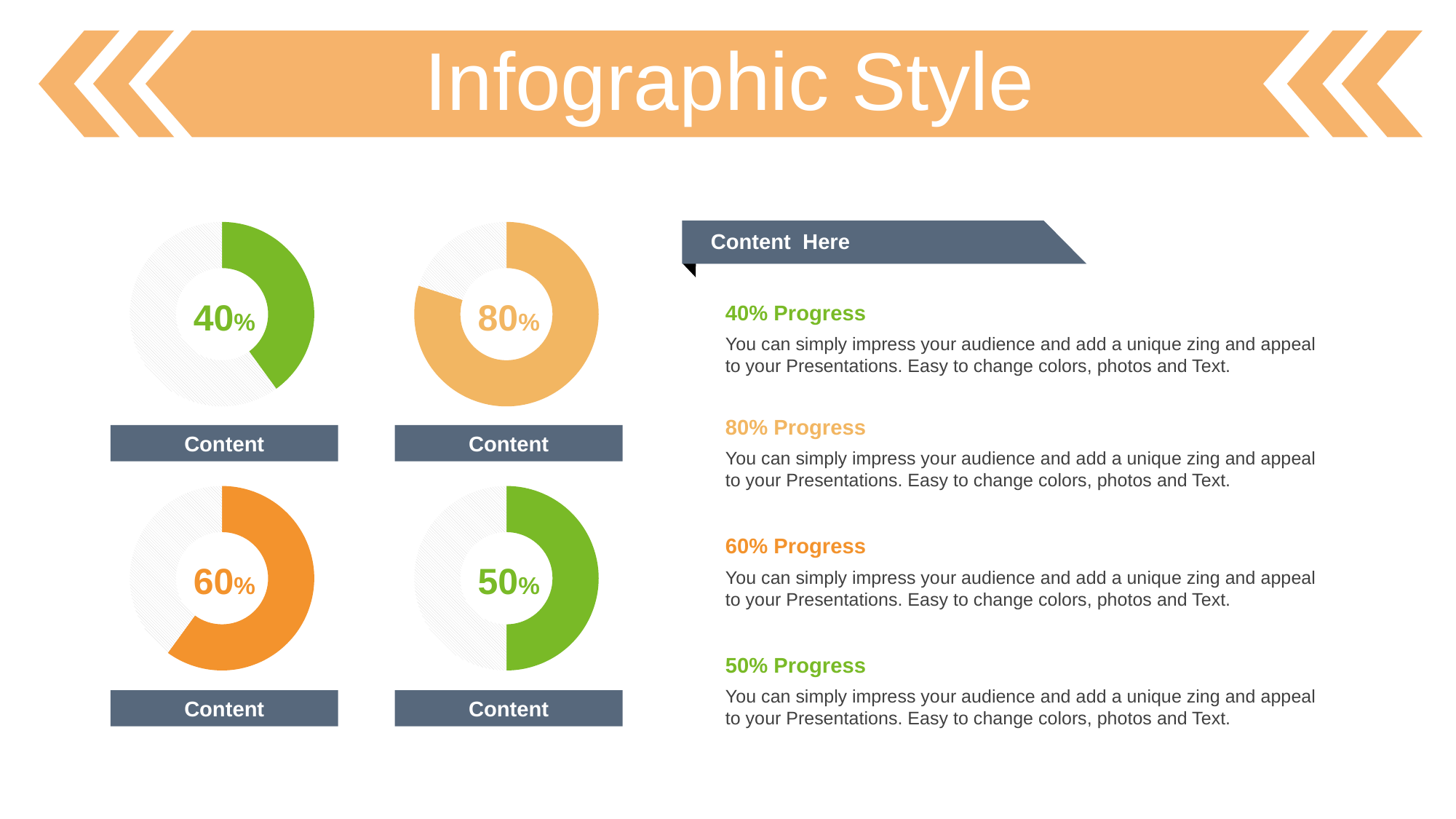
Which of the four donut charts shows the highest percentage? The top-right chart (80%) What value is shown in the bottom-left donut chart? 60% What value is shown in the bottom-right donut chart? 50% Which is larger, the value in the bottom-left donut chart or the value in the bottom-right donut chart? The bottom-left chart (60%) What kind of chart is used to show the percentages on the slide? Donut chart How many donut charts are on the slide? 4 What value is shown in the top-right donut chart? 80% What colour is the filled portion of the bottom-left donut chart? Orange What value is shown in the top-left donut chart? 40% Which of the four donut charts shows the lowest percentage? The top-left chart (40%) What is the difference between the value in the top-right donut chart and the value in the top-left donut chart? 40% What is the difference between the value in the bottom-left donut chart and the value in the bottom-right donut chart? 10%